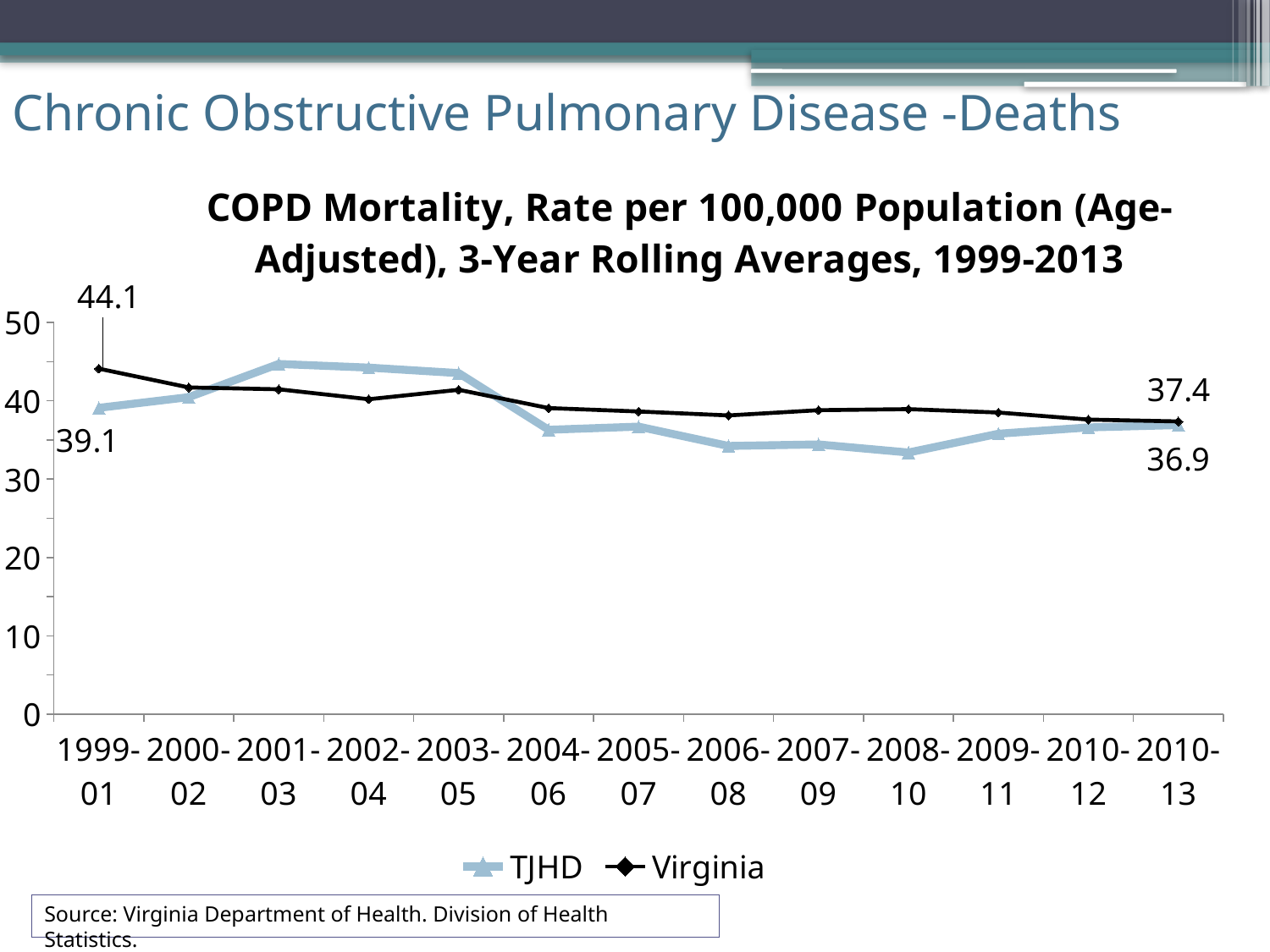
What kind of chart is shown on the slide? line chart By how much did the Virginia rate fall from 1999-01 to 2010-13? 6.7 Is the TJHD value for 2001-03 greater or less than 40? greater How many time periods are shown on the x axis? 13 What is the TJHD COPD mortality rate for 1999-01? 39.1 How many series does the legend list? 2 What is the TJHD COPD mortality rate for the final period, 2010-13? 36.9 In 1999-01, which series has the higher rate, TJHD or Virginia? Virginia What is the Virginia COPD mortality rate for 1999-01? 44.1 Is the TJHD value for 2008-10 greater or less than 40? less What is the Virginia COPD mortality rate for the final period, 2010-13? 37.4 By how much does the Virginia rate exceed the TJHD rate in 1999-01? 5.0